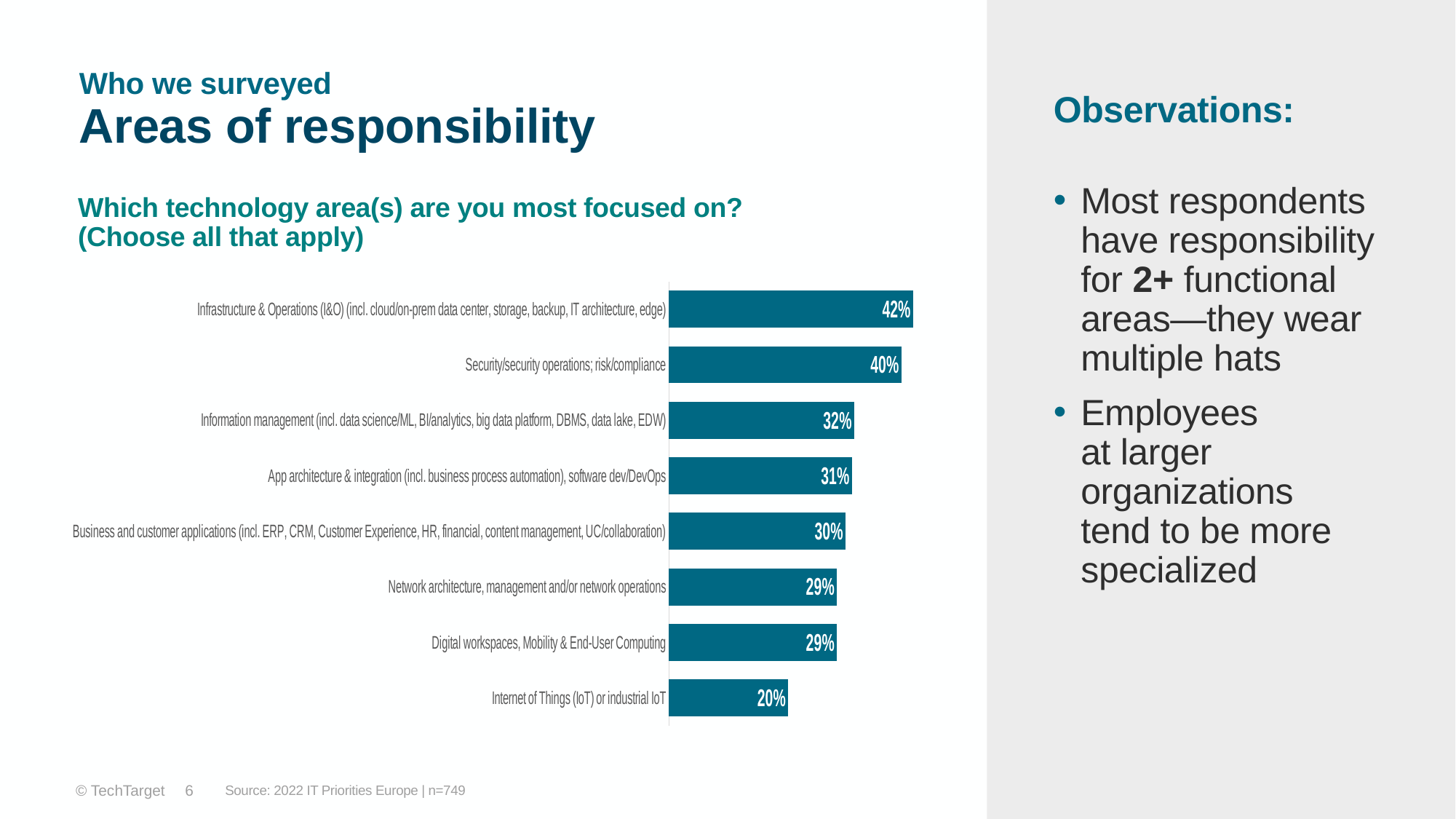
Which has a larger value: Business and customer applications or Digital workspaces, Mobility & End-User Computing? Business and customer applications Which two technology areas share the same value of 29%? Network architecture, management and/or network operations; Digital workspaces, Mobility & End-User Computing What is the survey question shown above the chart? Which technology area(s) are you most focused on? (Choose all that apply) What is the difference between Security/security operations; risk/compliance and App architecture & integration? 9 What is the difference in percentage points between Infrastructure & Operations (I&O) and Internet of Things (IoT) or industrial IoT? 22 What is the value for Internet of Things (IoT) or industrial IoT? 20% What percentage is shown for Information management? 32% Which technology area has the highest percentage of respondents? Infrastructure & Operations (I&O) Which technology area has the lowest percentage of respondents? Internet of Things (IoT) or industrial IoT How many technology areas are shown in the chart? 8 What kind of chart is used on this slide? Bar chart What percentage of respondents are focused on Security/security operations; risk/compliance? 40%